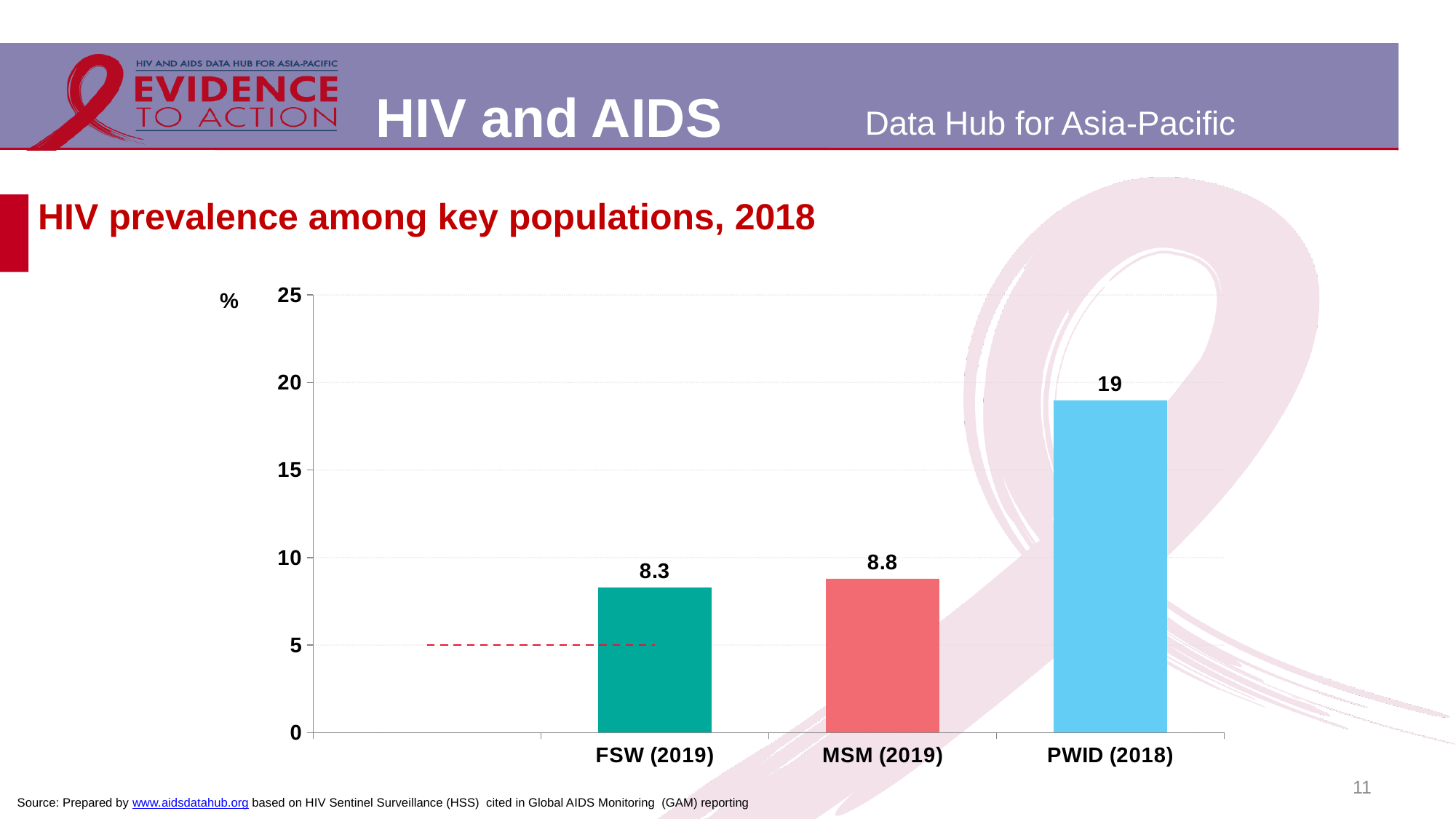
What is the difference between the HIV prevalence for PWID (2018) and MSM (2019)? 10.2 What is the HIV prevalence value shown for PWID (2018)? 19 What is the HIV prevalence value shown for MSM (2019)? 8.8 Is the value for PWID (2018) greater or less than 15? greater What is the difference between the HIV prevalence for MSM (2019) and FSW (2019)? 0.5 What is the title of the chart on the slide? HIV prevalence among key populations, 2018 How many key population categories are plotted on the chart? 3 Which key population has the lowest HIV prevalence on the chart? FSW (2019) Which key population has the highest HIV prevalence on the chart? PWID (2018) What type of chart is shown on the slide? Bar chart What is the HIV prevalence value shown for FSW (2019)? 8.3 Which is larger, the HIV prevalence for PWID (2018) or for FSW (2019)? PWID (2018)